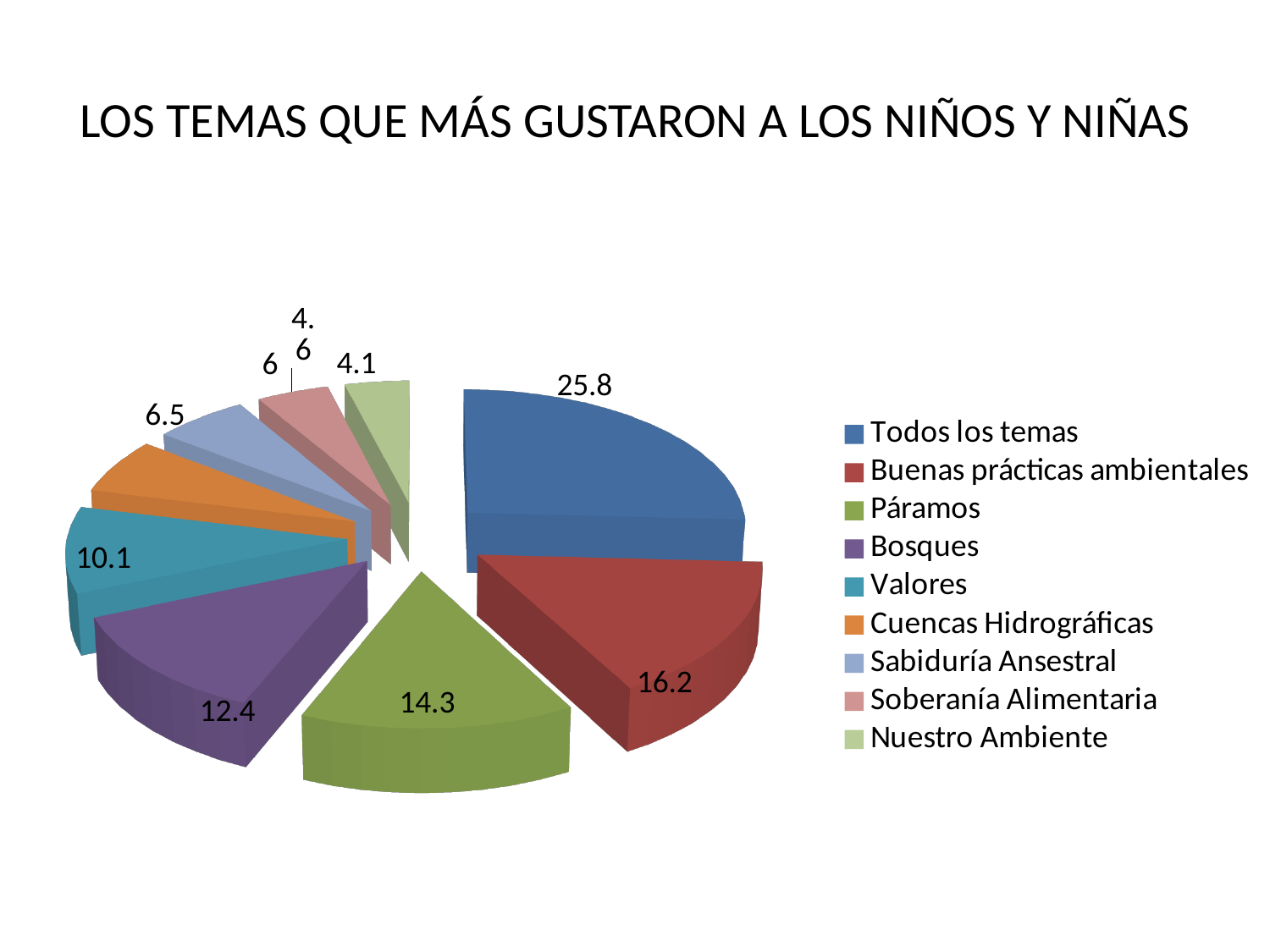
Which is larger, the value for Páramos or the value for Bosques? Páramos Which topic has the smallest slice of the pie? Nuestro Ambiente Which topic has the largest slice of the pie? Todos los temas What is the value for Bosques? 12.4 What is the value for Valores? 10.1 How many slices does the pie chart have? 9 What kind of chart is shown on the slide? Pie chart What is the difference between the values for Todos los temas and Buenas prácticas ambientales? 9.6 What is the value for Páramos? 14.3 What is the title of the chart on the slide? LOS TEMAS QUE MÁS GUSTARON A LOS NIÑOS Y NIÑAS What is the value for Todos los temas? 25.8